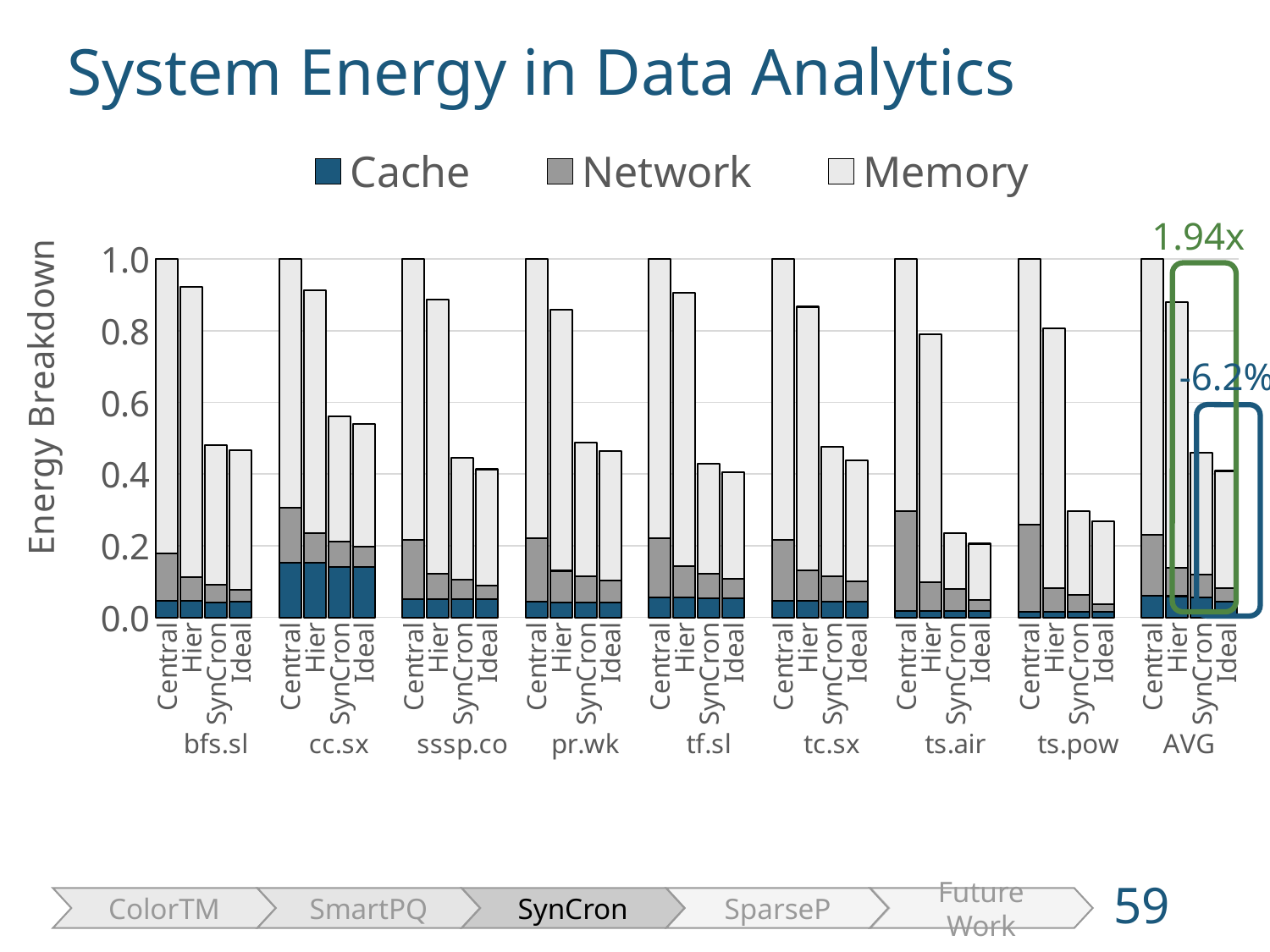
What kind of chart is shown on the slide? bar chart Is the total value of the SynCron bar for bfs.sl greater or less than 0.6? less Within the AVG group, which configuration has the highest total energy breakdown? Central How many bars are plotted within each workload group? 4 What is the total energy breakdown value of the Central bar for bfs.sl? 1.0 How many workload groups are shown along the x axis (including AVG)? 9 What are the three series named in the legend? Cache, Network, Memory How many series does the legend list? 3 Within each workload group, do the bar totals rise or fall going from Central to Ideal? fall What annotation is printed in green above the AVG group? 1.94x For tf.sl, which bar is taller: Hier or SynCron? Hier Is the total value of the Hier bar for cc.sx greater or less than 0.8? greater